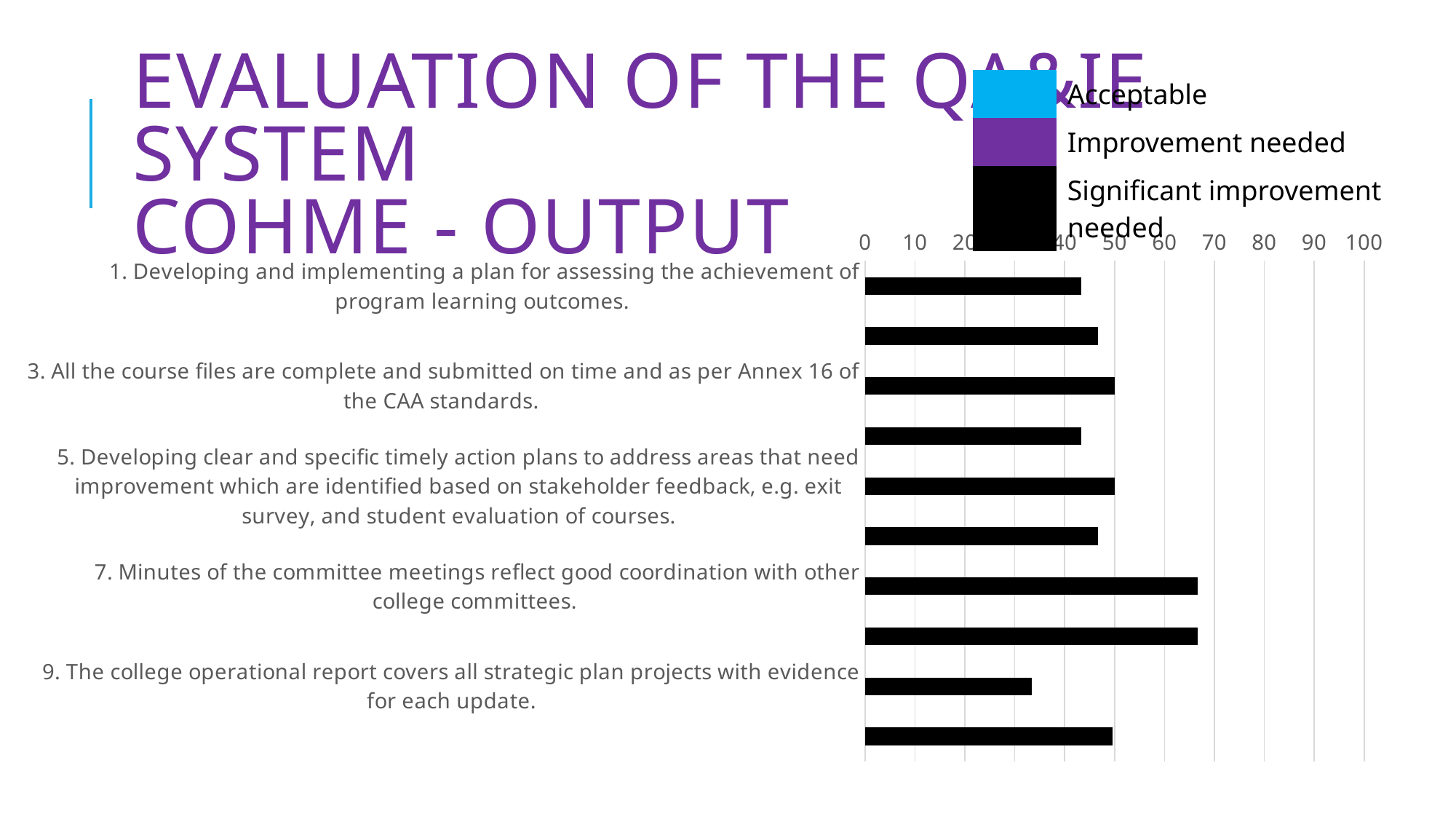
Which has the larger value: item 1 (Developing and implementing a plan for assessing program learning outcomes) or item 9 (The college operational report)? item 1 (Developing and implementing a plan for assessing program learning outcomes) Is the value for item 1 (Developing and implementing a plan for assessing the achievement of program learning outcomes) greater or less than 40? greater What is the highest value shown on the chart's horizontal axis? 100 Which has the larger value: item 7 (Minutes of the committee meetings) or item 9 (The college operational report)? item 7 (Minutes of the committee meetings) What kind of chart is shown on the slide? bar chart Which category has the shortest bar in the chart? 9. The college operational report covers all strategic plan projects with evidence for each update. Is the value for item 1 (Developing and implementing a plan for assessing the achievement of program learning outcomes) greater or less than 50? less Is the value for item 9 (The college operational report covers all strategic plan projects with evidence for each update) greater or less than 40? less How many bars are plotted in the chart? 10 How many series does the chart legend list? 3 Which legend entry is shown in black? Significant improvement needed